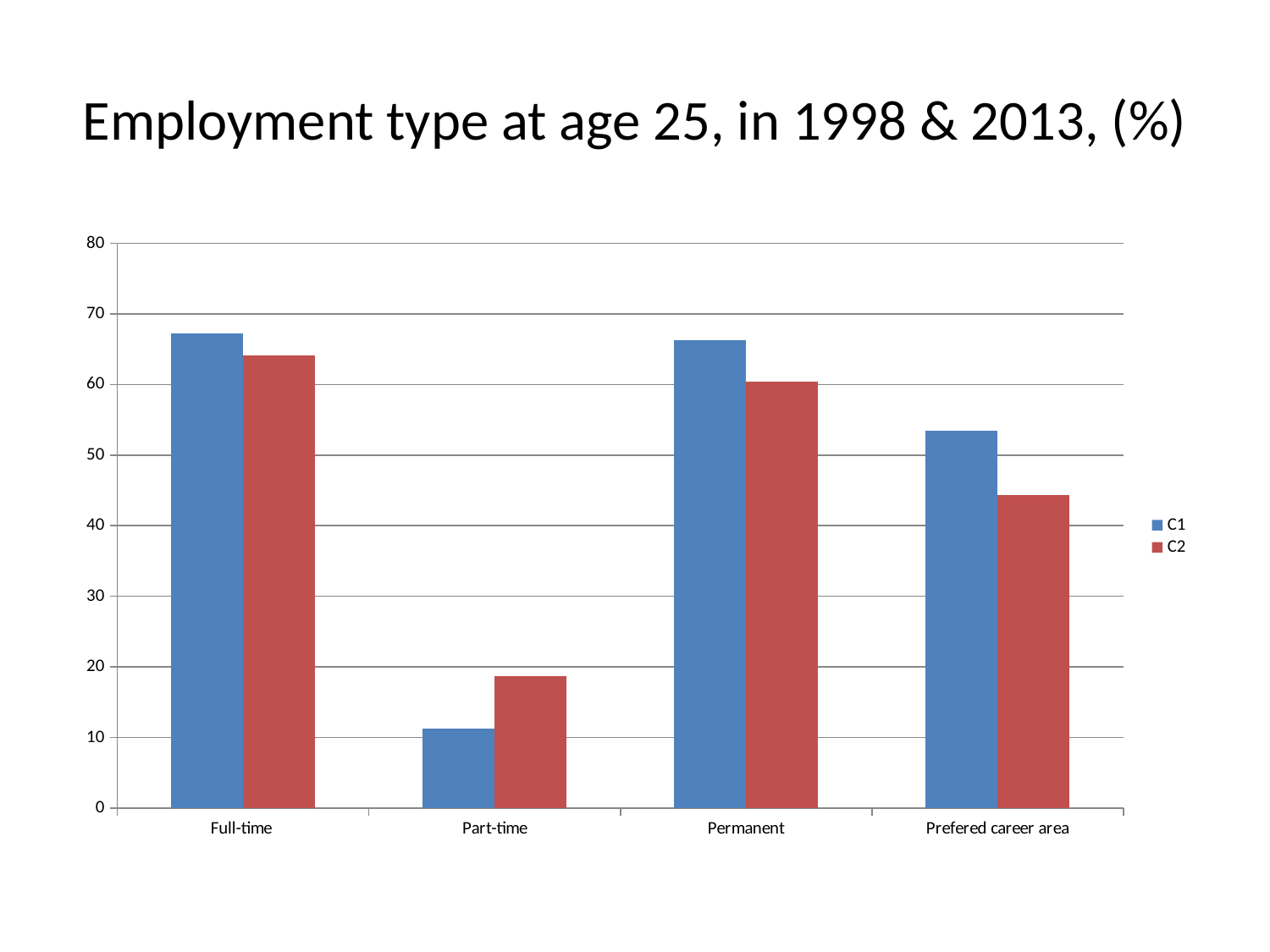
Which category has the lowest value for C1? Part-time Is the value for Full-time in series C1 greater or less than 60? greater How many categories are shown on the x axis? 4 Which category has the highest value for C2? Full-time For Prefered career area, which series has the larger value, C1 or C2? C1 For Part-time, which series has the larger value, C1 or C2? C2 What kind of chart is shown on the slide? bar chart Is the value for Prefered career area in series C2 greater or less than 50? less Is the value for Part-time in series C1 greater or less than 20? less Which category has the lowest value for C2? Part-time What is the title of the chart? Employment type at age 25, in 1998 & 2013, (%) How many series does the legend list? 2